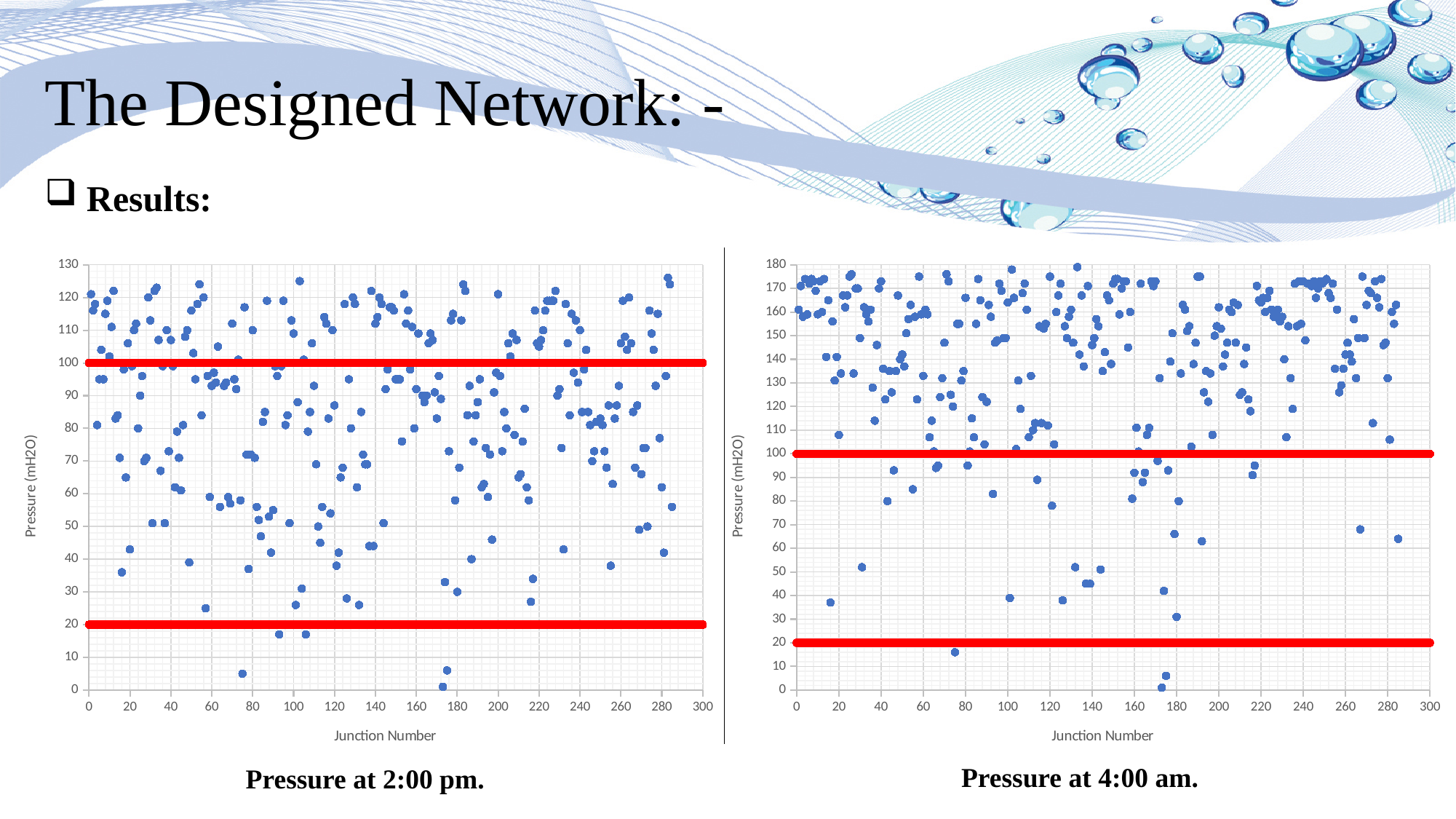
What kind of chart is the 'Pressure at 4:00 am.' chart on the right? Scatter chart Which chart has the higher maximum value on its y-axis, 'Pressure at 2:00 pm.' or 'Pressure at 4:00 am.'? Pressure at 4:00 am. In the 'Pressure at 4:00 am.' chart, at what pressure value is the upper red horizontal line drawn? 100 In the 'Pressure at 4:00 am.' chart, is the highest plotted pressure greater or less than 170? greater In the 'Pressure at 2:00 pm.' chart, at what pressure value is the lower red horizontal line drawn? 20 In the 'Pressure at 4:00 am.' chart, at what pressure value is the lower red horizontal line drawn? 20 In the 'Pressure at 2:00 pm.' chart, what is the x-axis title? Junction Number What kind of chart is the 'Pressure at 2:00 pm.' chart on the left? Scatter chart In the 'Pressure at 2:00 pm.' chart, is the highest plotted pressure greater or less than 120? greater In the 'Pressure at 2:00 pm.' chart, at what pressure value is the upper red horizontal line drawn? 100 In the 'Pressure at 4:00 am.' chart, what is the y-axis title? Pressure (mH2O) In the 'Pressure at 4:00 am.' chart, is the lowest plotted pressure greater or less than 10? less